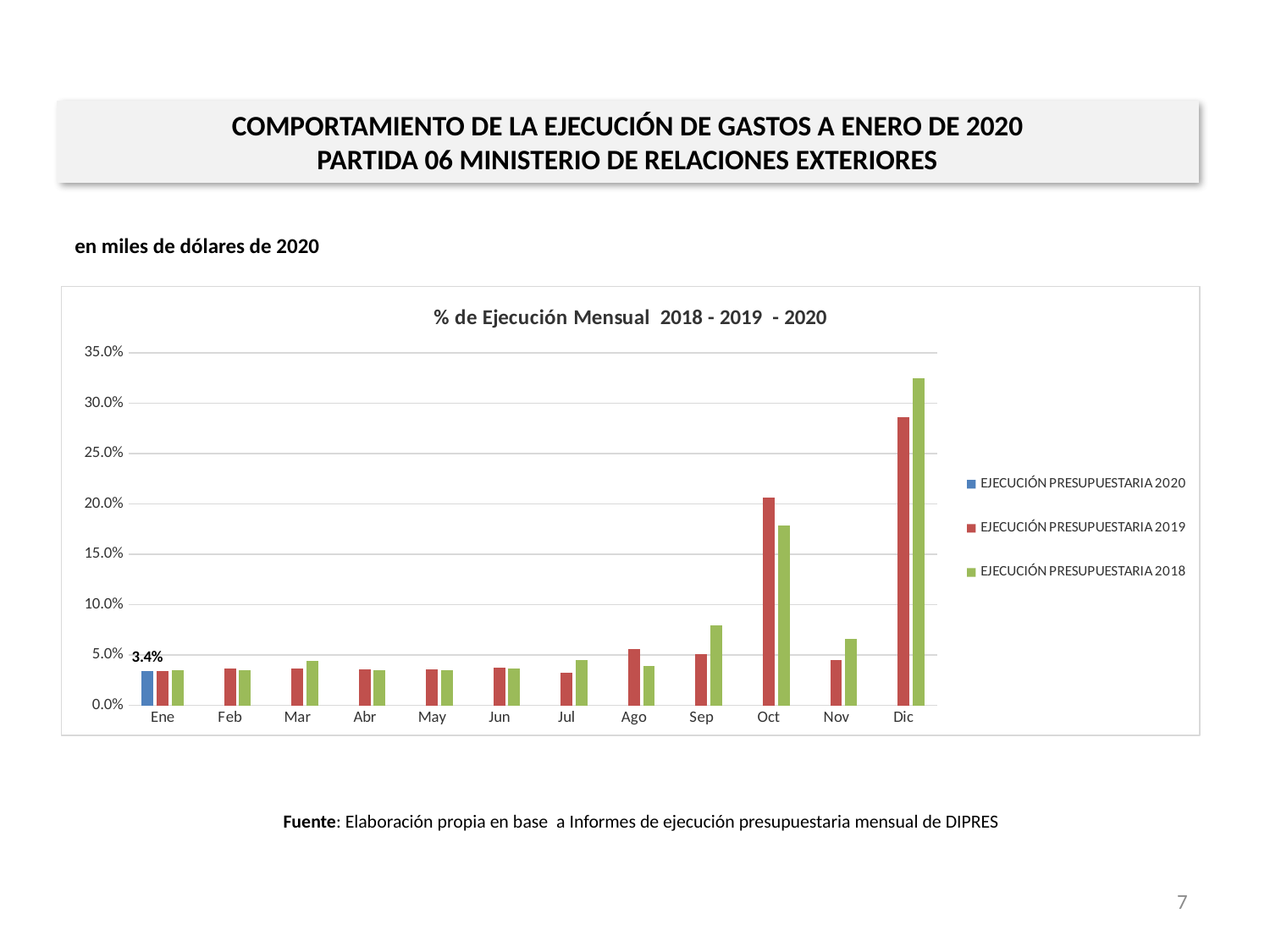
In Dic, which series has the larger value, EJECUCIÓN PRESUPUESTARIA 2018 or EJECUCIÓN PRESUPUESTARIA 2019? EJECUCIÓN PRESUPUESTARIA 2018 How many series does the legend list? 3 Is the value for EJECUCIÓN PRESUPUESTARIA 2018 in Sep greater or less than 5.0%? greater In Oct, which series has the larger value, EJECUCIÓN PRESUPUESTARIA 2018 or EJECUCIÓN PRESUPUESTARIA 2019? EJECUCIÓN PRESUPUESTARIA 2019 Which month has the highest value for EJECUCIÓN PRESUPUESTARIA 2018? Dic Is the value for EJECUCIÓN PRESUPUESTARIA 2018 in Dic greater or less than 30.0%? greater How many months are shown on the x axis of the chart? 12 Is the value for EJECUCIÓN PRESUPUESTARIA 2019 in Dic greater or less than 30.0%? less What is the value for EJECUCIÓN PRESUPUESTARIA 2020 in Ene? 3.4% What kind of chart is shown on the slide? Bar chart Which month has the highest value for EJECUCIÓN PRESUPUESTARIA 2019? Dic